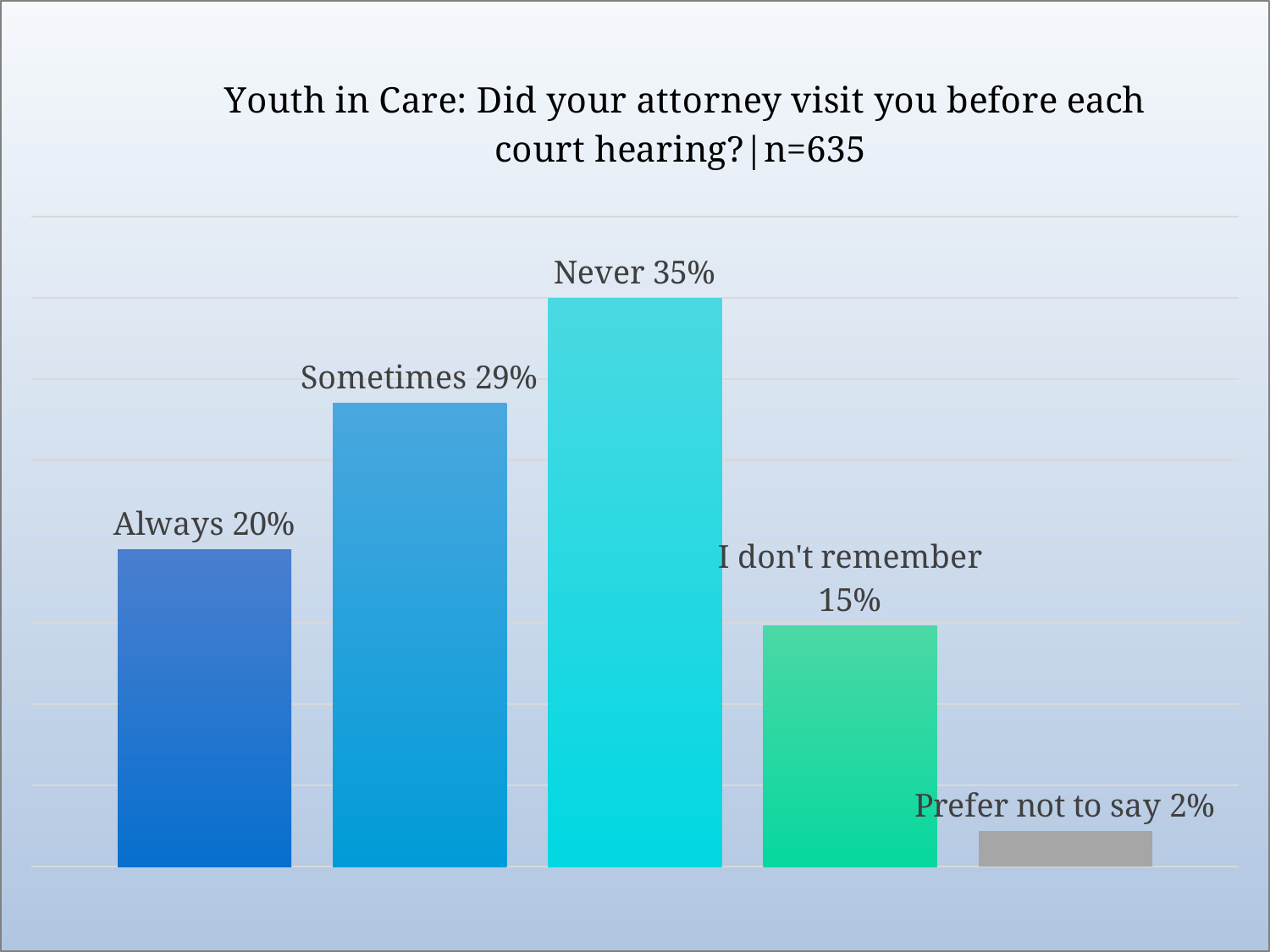
Which response has the lowest percentage? Prefer not to say What percentage of youth in care answered "Always"? 20% What is the difference in percentage points between "Sometimes" and "I don't remember"? 14 How many response categories are shown in the chart? 5 What percentage of youth in care answered "Prefer not to say"? 2% What percentage of youth in care answered "I don't remember"? 15% What kind of chart is shown on the slide? Bar chart What percentage of youth in care answered "Never"? 35% Which is larger, the percentage for "Sometimes" or for "Always"? Sometimes Which response has the highest percentage? Never What is the difference in percentage points between "Never" and "Always"? 15 What percentage of youth in care answered "Sometimes"? 29%